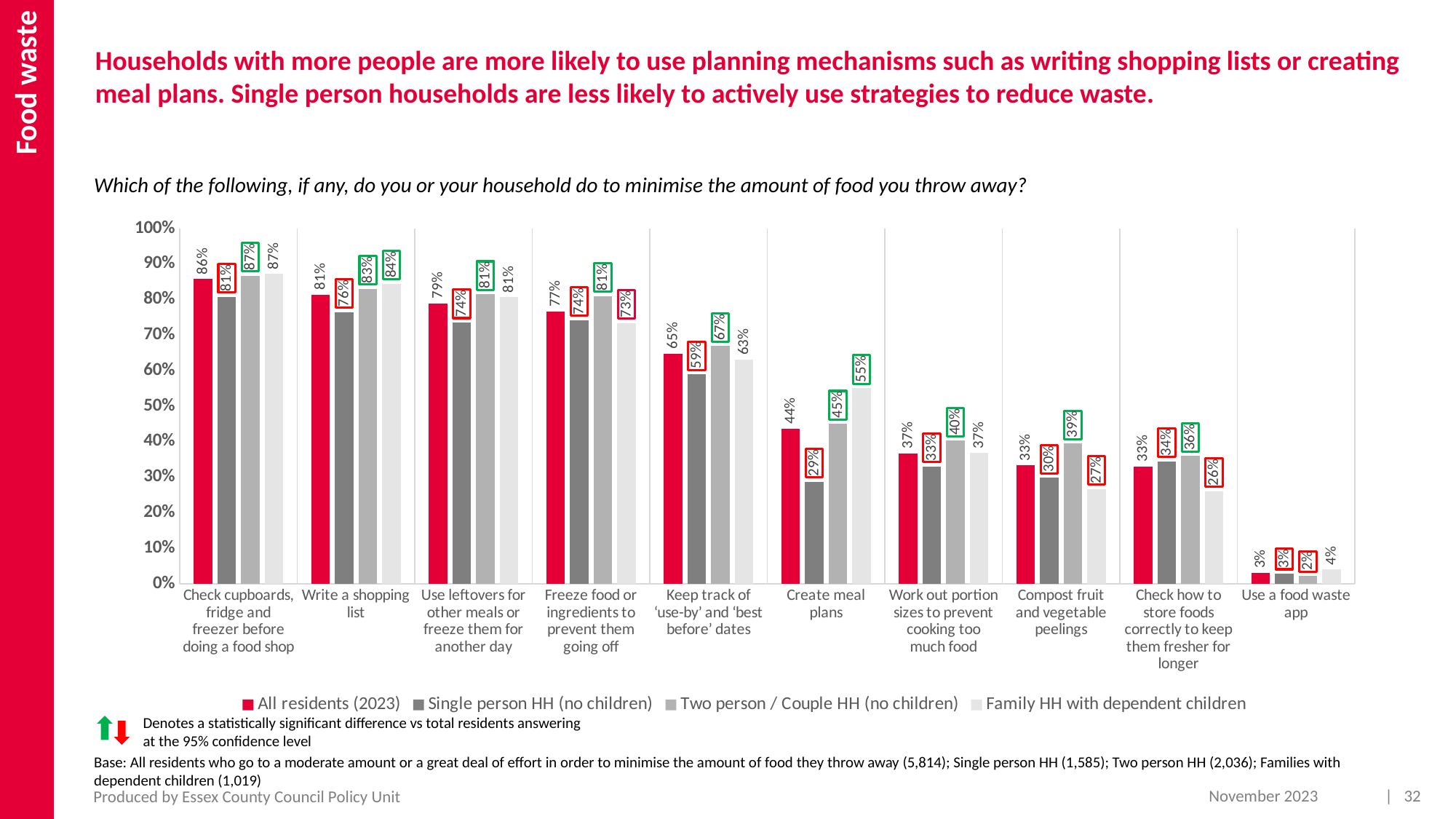
What is the value for Family HH with dependent children for 'Create meal plans'? 55% How many series does the legend list? 4 For 'Compost fruit and vegetable peelings', which is larger: Single person HH (no children) or Family HH with dependent children? Single person HH (no children) What percentage of all residents (2023) say they create meal plans? 44% How many categories are shown on the x axis? 10 Which category has the highest value for All residents (2023)? Check cupboards, fridge and freezer before doing a food shop Do the values for All residents (2023) generally rise or fall from left to right along the x axis? Fall What is the difference between Family HH with dependent children and Single person HH (no children) for 'Create meal plans'? 26 percentage points What percentage of Single person HH (no children) write a shopping list? 76% What is the value for Two person / Couple HH (no children) for 'Compost fruit and vegetable peelings'? 39% Which category has the lowest value for All residents (2023)? Use a food waste app What kind of chart is shown on the slide? Bar chart